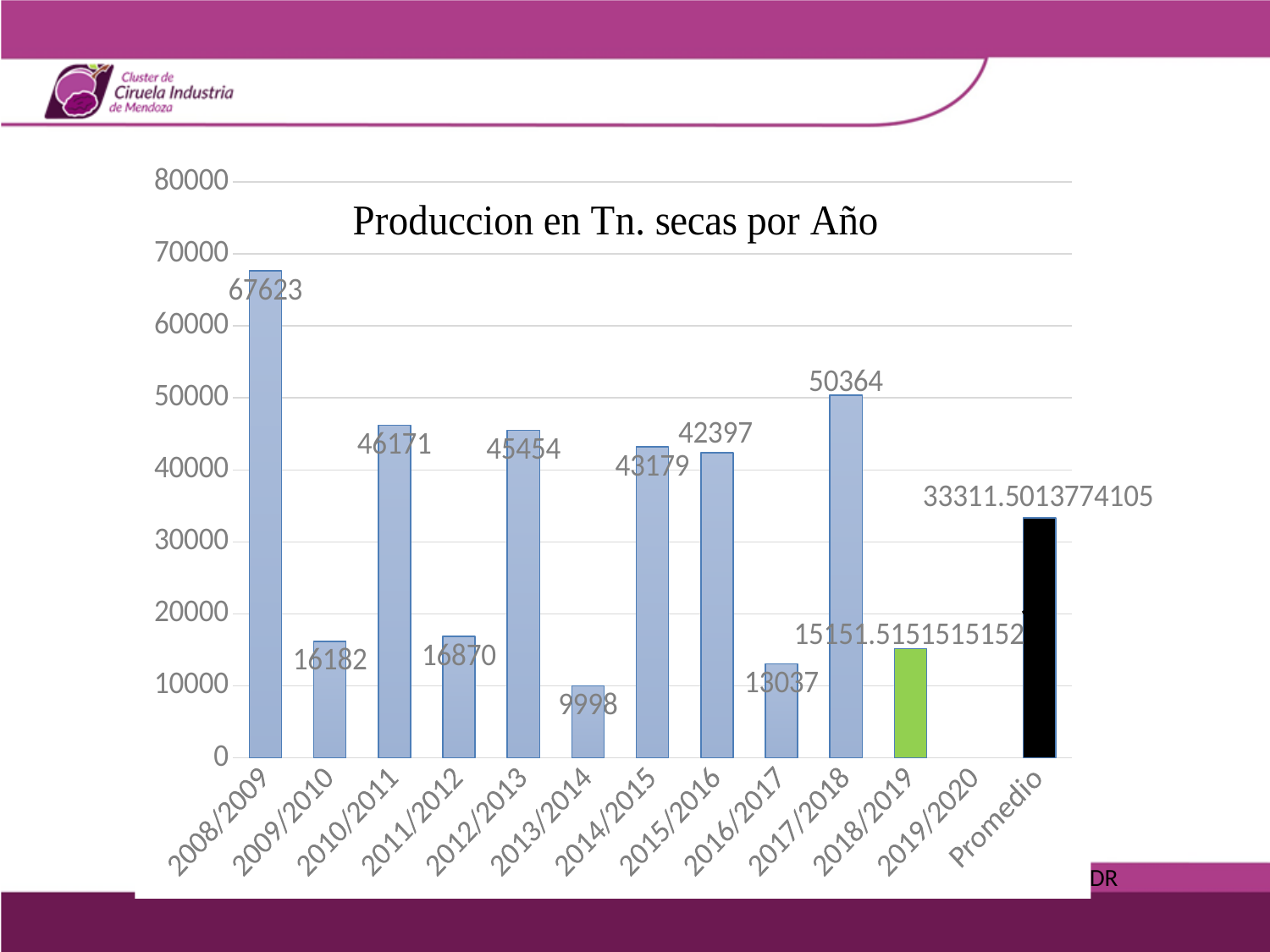
What value is shown for the Promedio bar? 33311.5013774105 What kind of chart is shown on the slide? bar chart Is the value for 2016/2017 greater or less than 20000? less What is the title of the chart? Produccion en Tn. secas por Año Which year has the lowest production? 2013/2014 What is the difference between the production in 2008/2009 and 2017/2018? 17259 Which year has the highest production? 2008/2009 What is the value shown for 2013/2014? 9998 Which is larger, the production in 2010/2011 or in 2012/2013? 2010/2011 How many category labels are shown on the x axis? 13 What is the production value for 2008/2009? 67623 What is the production value for 2017/2018? 50364